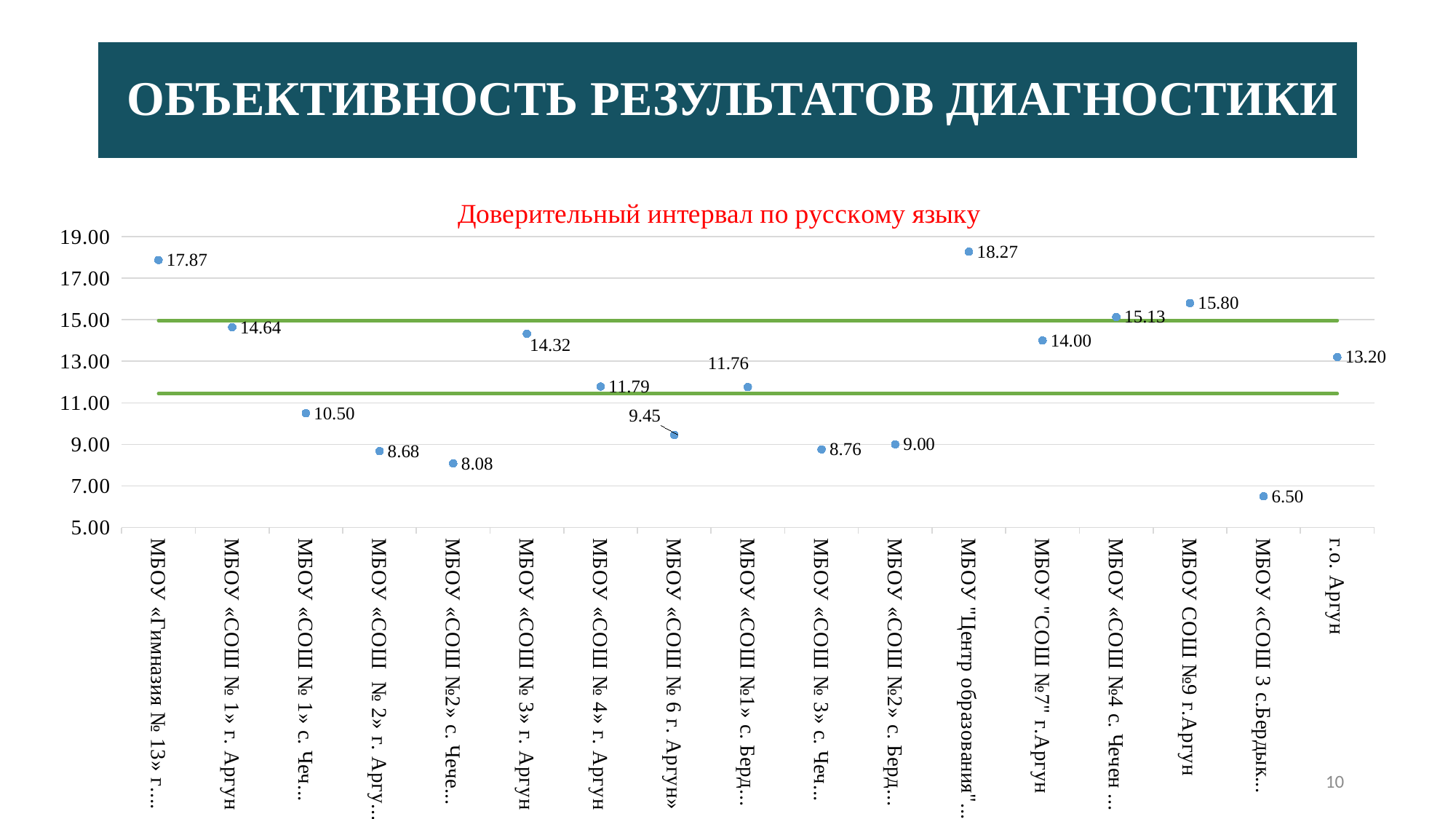
What is the title of the chart? Доверительный интервал по русскому языку Which category has the lowest value? МБОУ «СОШ 3 с.Бердык... Which category has the highest value? МБОУ "Центр образования"... What is the value for МБОУ «СОШ № 6 г. Аргун»? 9.45 What kind of chart is shown? Scatter (dot) chart What is the value for г.о. Аргун? 13.20 What is the value for МБОУ «СОШ № 1» г. Аргун? 14.64 How many categories are plotted on the x axis? 17 What is the value for МБОУ СОШ №9 г.Аргун? 15.80 What is the difference between the values for МБОУ «СОШ № 4» г. Аргун and МБОУ «СОШ № 6 г. Аргун»? 2.34 Which is larger: the value for МБОУ "СОШ №7" г.Аргун or the value for МБОУ «СОШ № 1» г. Аргун? МБОУ «СОШ № 1» г. Аргун What is the value for МБОУ «СОШ № 3» г. Аргун? 14.32